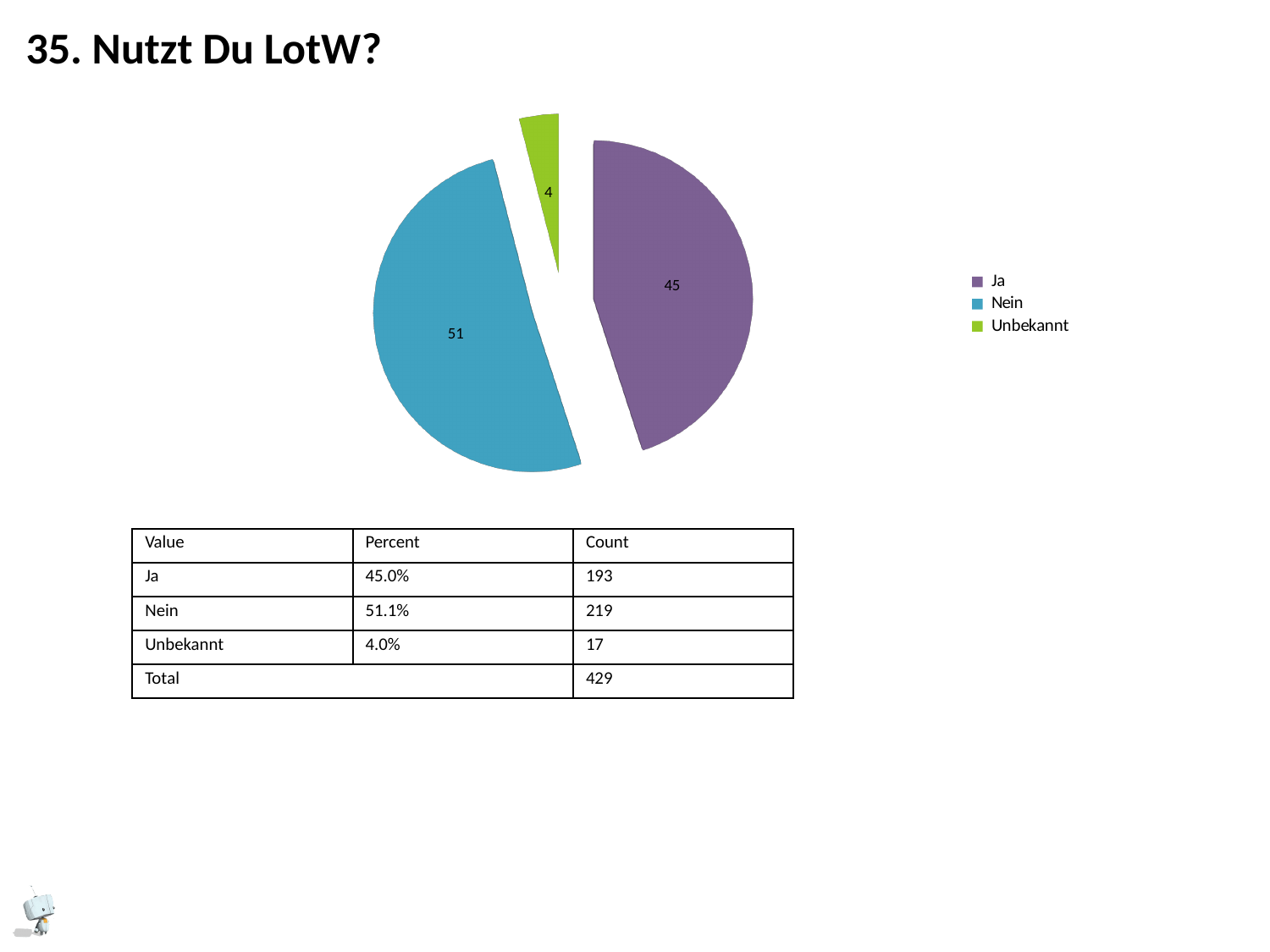
Which slice is larger, Ja or Nein? Nein How many slices does the pie chart have? 3 What is the difference between the values shown for Nein and Ja on the pie chart? 6 Which category has the largest slice of the pie? Nein What value is shown on the pie slice for Unbekannt? 4 What value is shown on the pie slice for Nein? 51 What kind of chart is shown on the slide? pie chart How many entries does the legend list? 3 Which category has the smallest slice of the pie? Unbekannt Which colour represents Unbekannt in the pie chart? green What value is shown on the pie slice for Ja? 45 What is the title of the slide containing the pie chart? 35. Nutzt Du LotW?